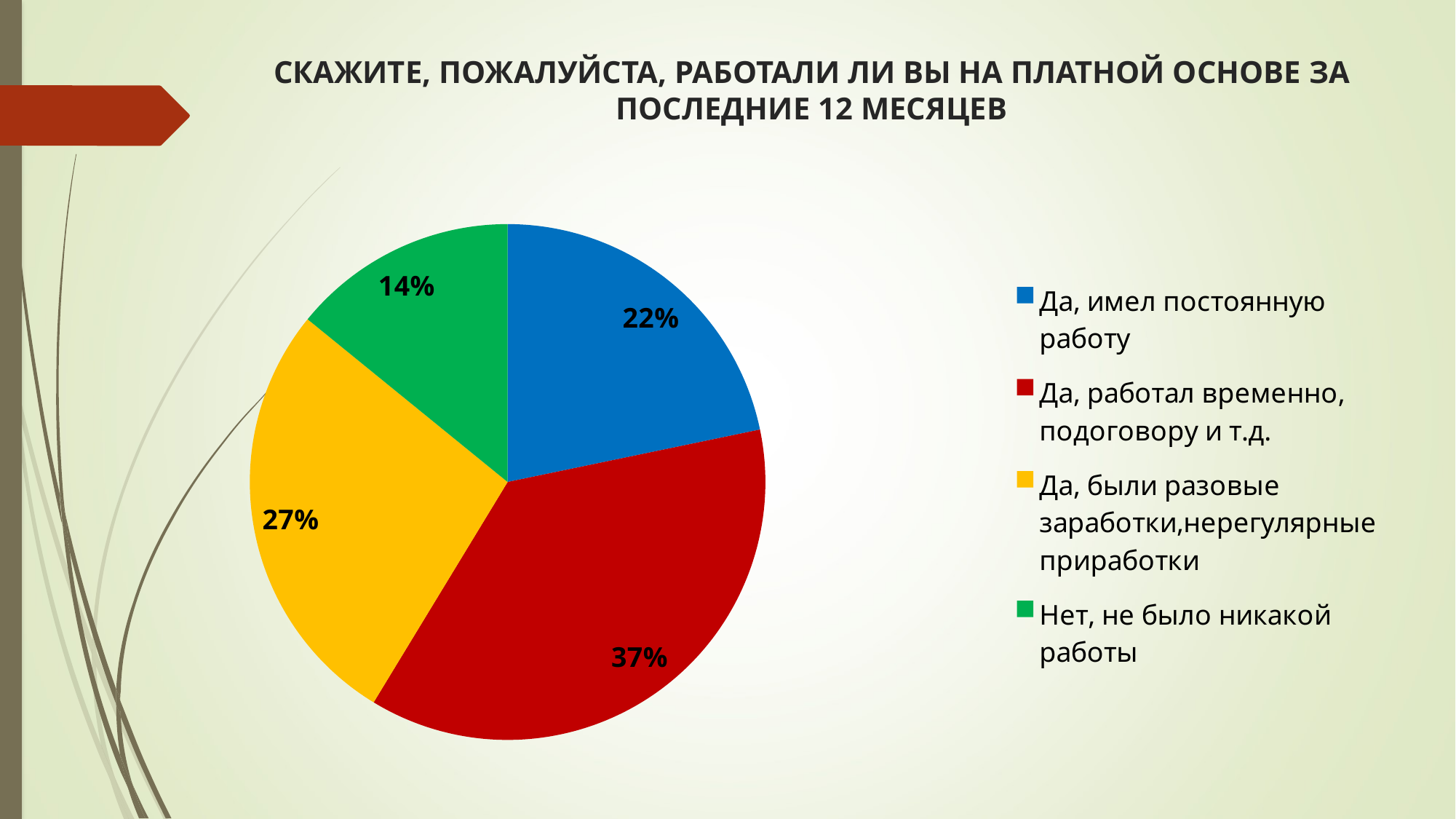
What is the combined share of the two categories "Да, имел постоянную работу" and "Нет, не было никакой работы"? 36% What colour is the slice for "Нет, не было никакой работы"? green How many categories does the pie chart have? 4 Which is larger: the share for "Да, были разовые заработки,нерегулярные приработки" or the share for "Да, имел постоянную работу"? Да, были разовые заработки,нерегулярные приработки What share of respondents answered "Да, имел постоянную работу"? 22% What kind of chart is shown on the slide? pie chart What share of respondents answered "Да, были разовые заработки,нерегулярные приработки"? 27% Which answer category has the largest slice of the pie? Да, работал временно, подоговору и т.д. Which answer category has the smallest slice of the pie? Нет, не было никакой работы What is the difference in percentage points between "Да, работал временно, подоговору и т.д." and "Да, имел постоянную работу"? 15 What share of respondents answered "Нет, не было никакой работы"? 14% What share of respondents answered "Да, работал временно, подоговору и т.д."? 37%